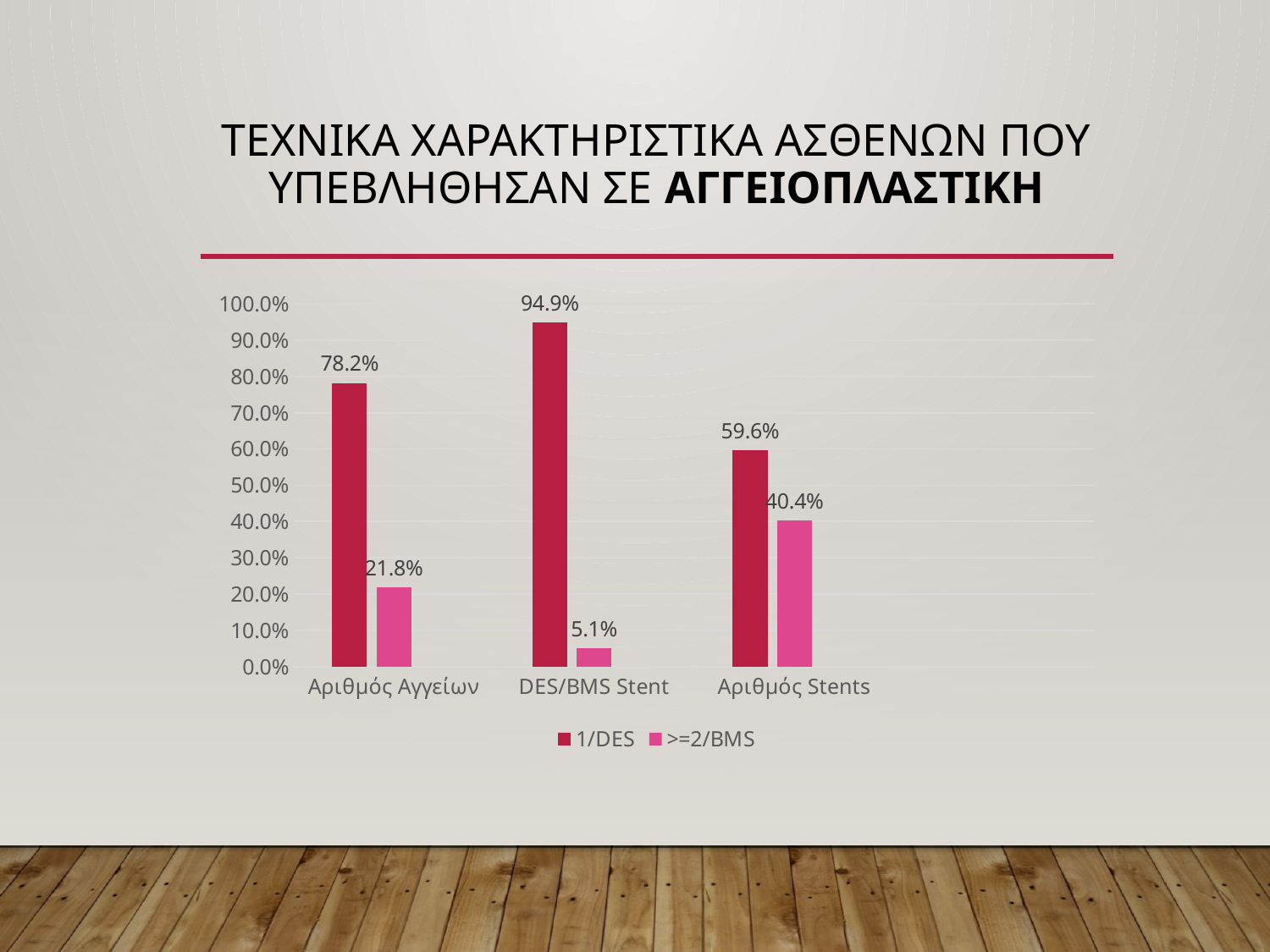
Which category has the highest 1/DES value? DES/BMS Stent How many categories are shown on the x axis? 3 What is the value of the 1/DES series for Αριθμός Αγγείων? 78.2% Which is larger for Αριθμός Αγγείων: the 1/DES value or the >=2/BMS value? 1/DES Which category has the lowest >=2/BMS value? DES/BMS Stent How many series does the legend list? 2 What kind of chart is shown on the slide? Bar chart What is the value of the >=2/BMS series for DES/BMS Stent? 5.1% Is the 1/DES value for Αριθμός Stents greater or less than 50.0%? greater What are the two series names listed in the legend? 1/DES and >=2/BMS What is the value of the >=2/BMS series for Αριθμός Stents? 40.4% What is the difference between the 1/DES and >=2/BMS values for Αριθμός Stents? 19.2%